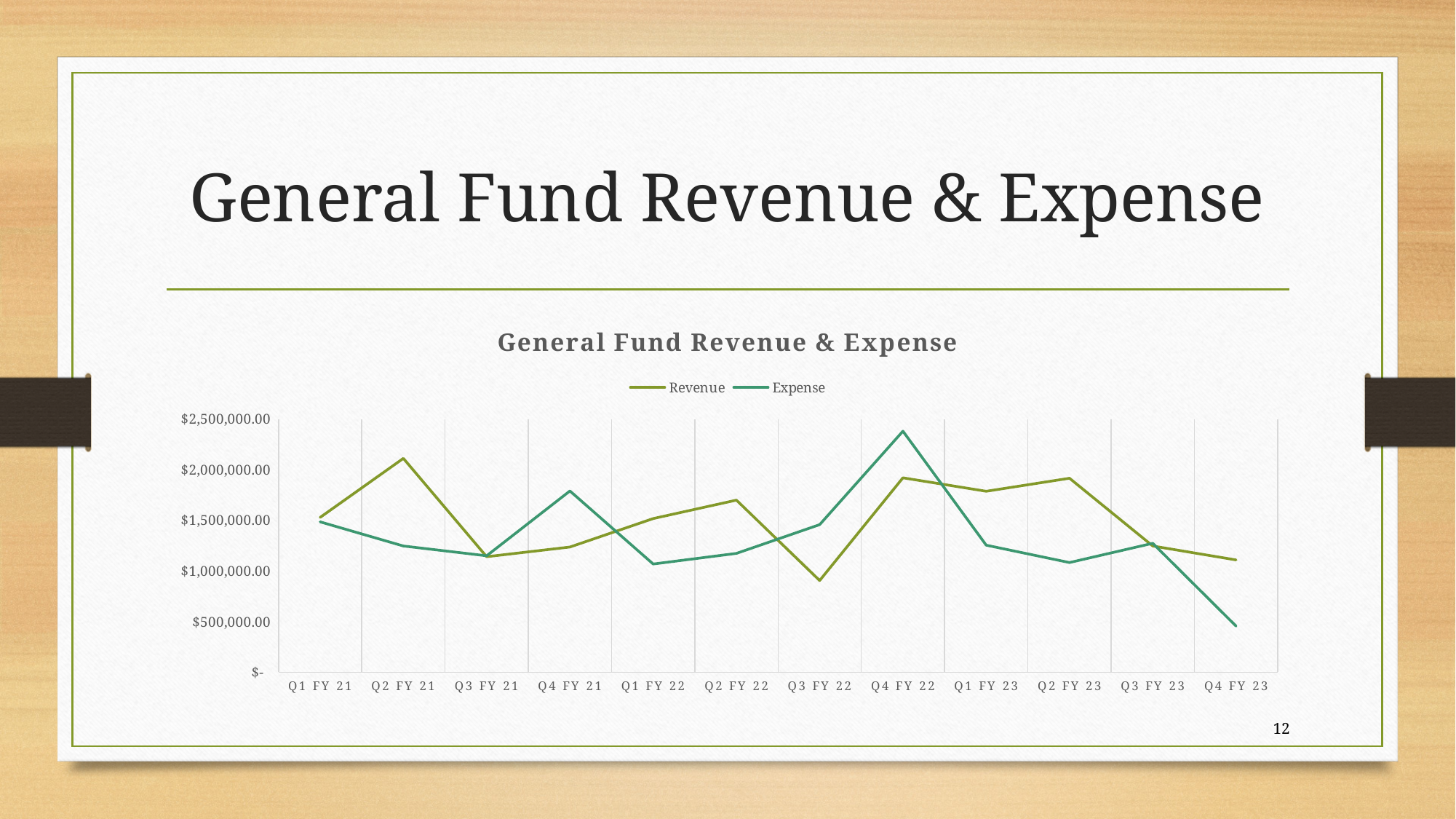
In which quarter is Revenue lowest? Q3 FY 22 Is the Expense value for Q4 FY 23 greater or less than $500,000.00? less How many series does the legend list? 2 In which quarter is Expense lowest? Q4 FY 23 What kind of chart is shown on the slide? Line chart How many quarters are plotted along the x axis? 12 In which quarter is Revenue highest? Q2 FY 21 Is the Revenue value for Q2 FY 21 greater or less than $2,000,000.00? greater Is the Revenue value for Q3 FY 22 greater or less than $1,000,000.00? less Does Revenue rise or fall from Q2 FY 23 to Q4 FY 23? Fall In Q4 FY 22, which is larger, Revenue or Expense? Expense In which quarter is Expense highest? Q4 FY 22